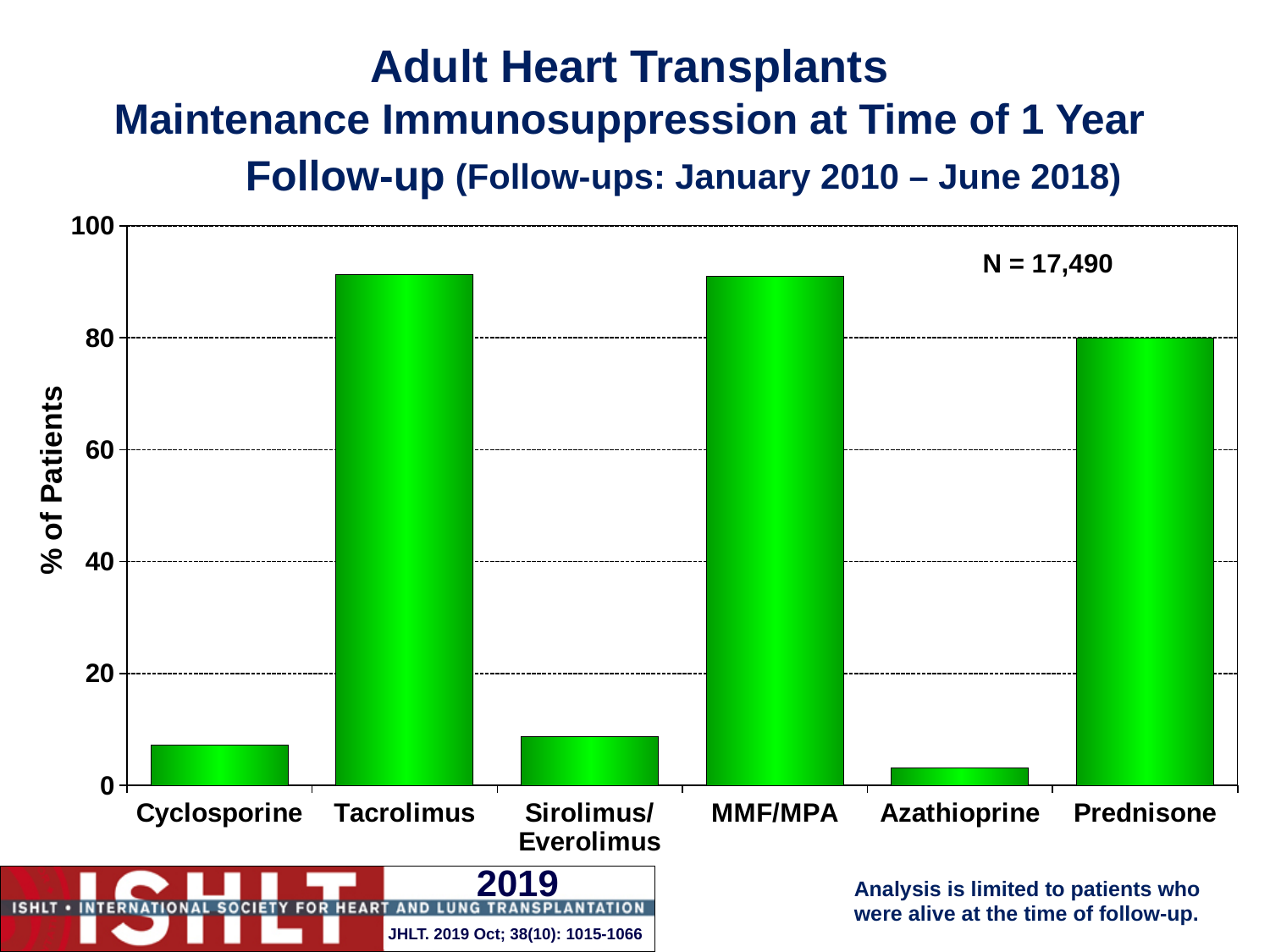
Which has a higher % of patients, Tacrolimus or Prednisone? Tacrolimus Is the value for MMF/MPA greater or less than 80? greater Is the value for Sirolimus/Everolimus greater or less than 20? less How many immunosuppression categories are shown on the x axis? 6 Which has a higher % of patients, Cyclosporine or Azathioprine? Cyclosporine Is the value for Tacrolimus greater or less than 80? greater Which category has the lowest % of patients? Azathioprine What is the N value shown on the chart? N = 17,490 What kind of chart is shown on the slide? bar chart